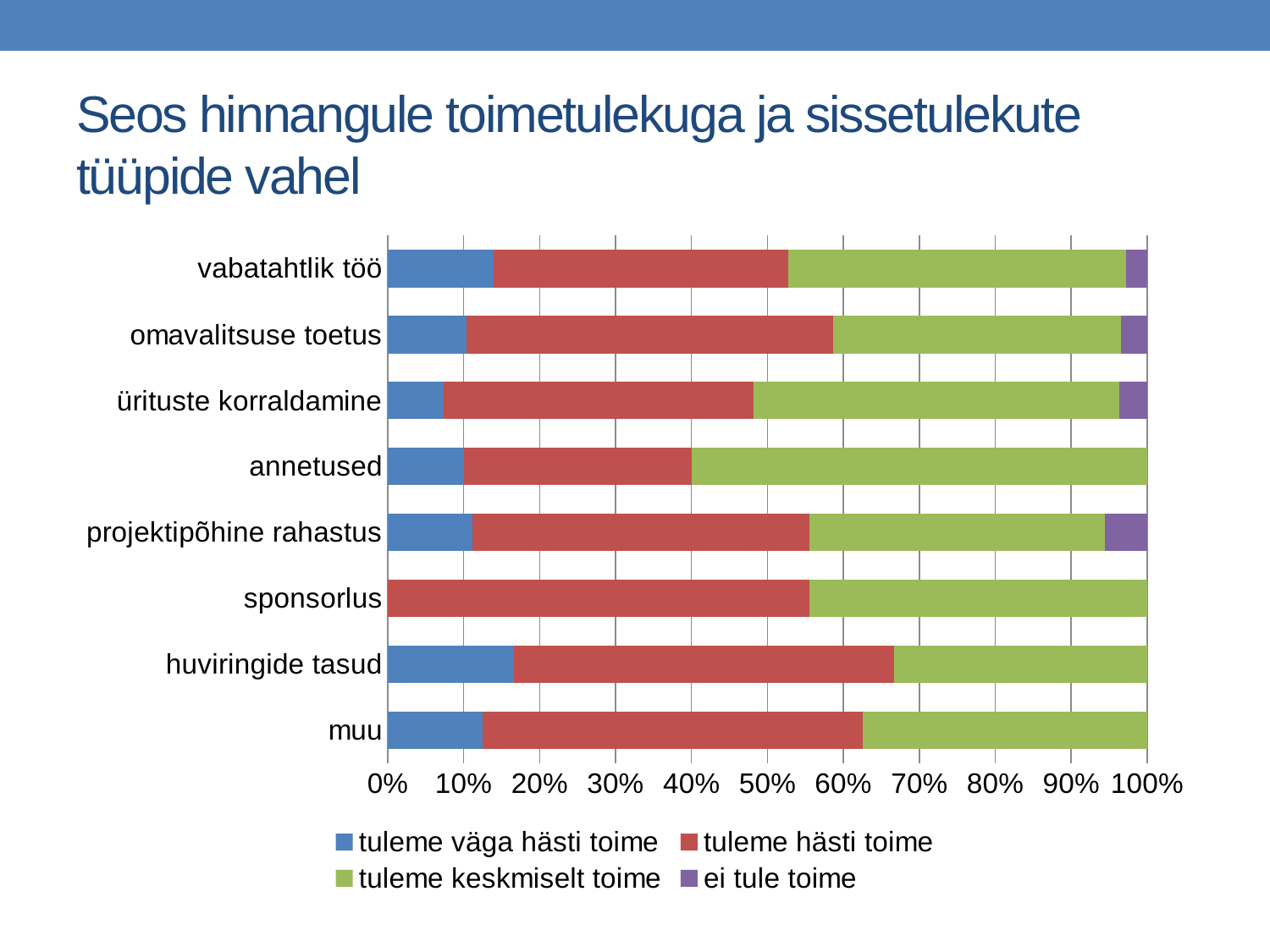
Which category has the largest 'ei tule toime' share? projektipõhine rahastus How many categories have no 'ei tule toime' segment? 4 Is the 'tuleme väga hästi toime' share for huviringide tasud greater or less than 10%? greater Which category has the largest 'tuleme väga hästi toime' share? huviringide tasud What is the title of the slide containing the chart? Seos hinnangule toimetulekuga ja sissetulekute tüüpide vahel How many income types (categories) are listed on the vertical axis of the chart? 8 Which category has no 'tuleme väga hästi toime' segment at all? sponsorlus Which legend entry is shown in green? tuleme keskmiselt toime Which has the larger 'tuleme väga hästi toime' share: vabatahtlik töö or omavalitsuse toetus? vabatahtlik töö Is the 'tuleme väga hästi toime' share for ürituste korraldamine greater or less than 10%? less How many series does the chart legend list? 4 What kind of chart is shown on the slide? Stacked bar chart